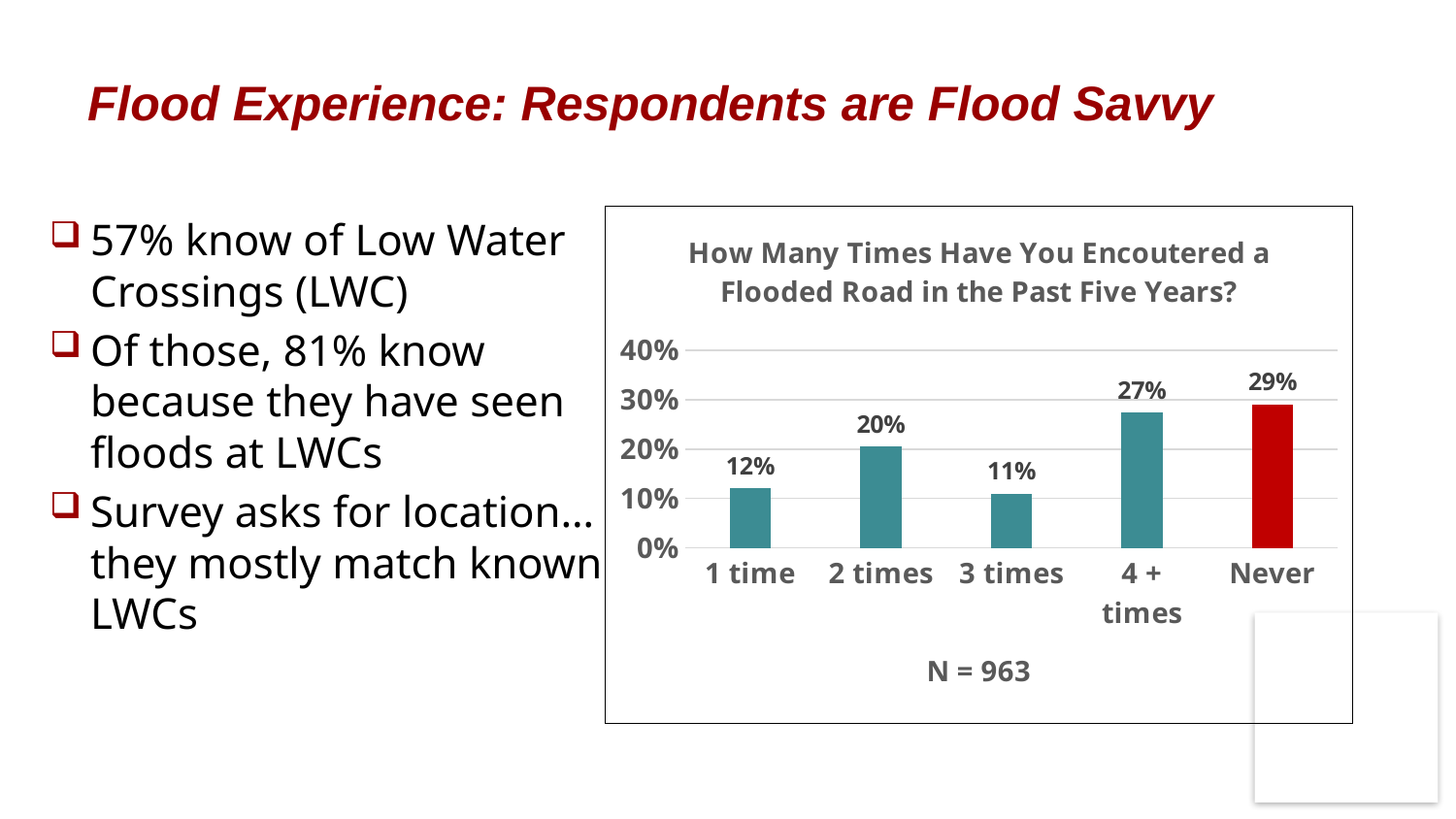
What percentage of respondents encountered a flooded road 1 time in the past five years? 12% What percentage of respondents answered 'Never'? 29% What is the difference between the 'Never' value and the '1 time' value? 17% What is the value for the '4 + times' category? 27% What kind of chart is shown on the slide? Bar chart What percentage of respondents encountered a flooded road 3 times? 11% Which category has the highest value? Never What is the sample size (N) noted below the chart? N = 963 How many categories are shown on the x axis? 5 Which is larger, the value for '2 times' or the value for '4 + times'? 4 + times What is the value for the '2 times' category? 20% Which category has the lowest value? 3 times